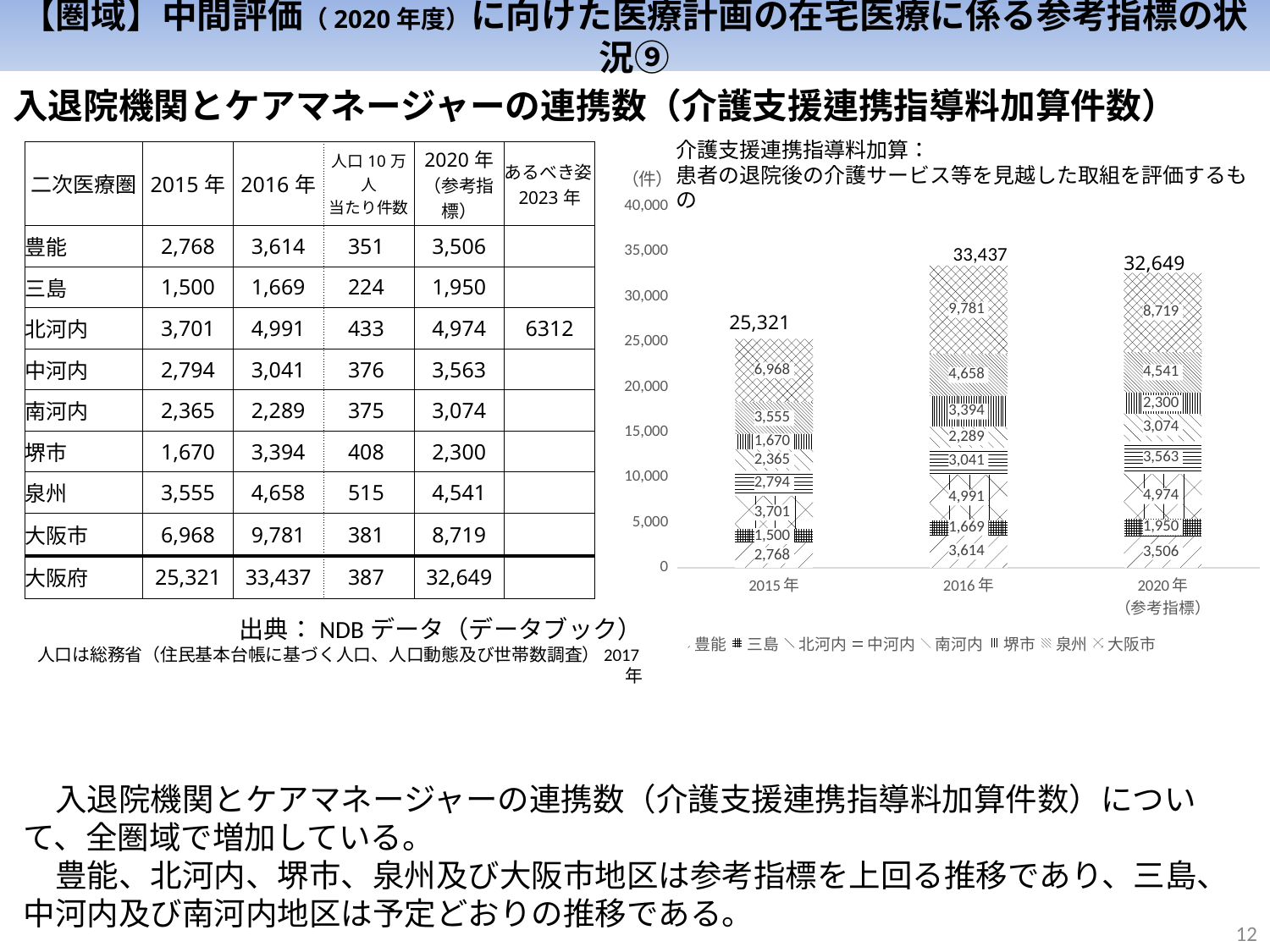
What is the value of the 堺市 segment in the 2015年 bar? 1,670 What is the value of the 大阪市 segment in the 2016年 bar? 9,781 What is the total of the stacked bar for 2016年? 33,437 Which bar has the highest total in the chart? 2016年 How many bars (categories) are plotted on the x axis of the chart? 3 What is the value of the 泉州 segment in the 2020年（参考指標） bar? 4,541 How many series does the chart legend list? 8 What is the difference between the 大阪市 segment in 2016年 and in 2015年? 2,813 What kind of chart is shown on the slide? stacked bar chart What is the total of the stacked bar for 2015年? 25,321 Is the total of the 2020年（参考指標） bar greater or less than 30,000? greater Which bar has the lowest total in the chart? 2015年